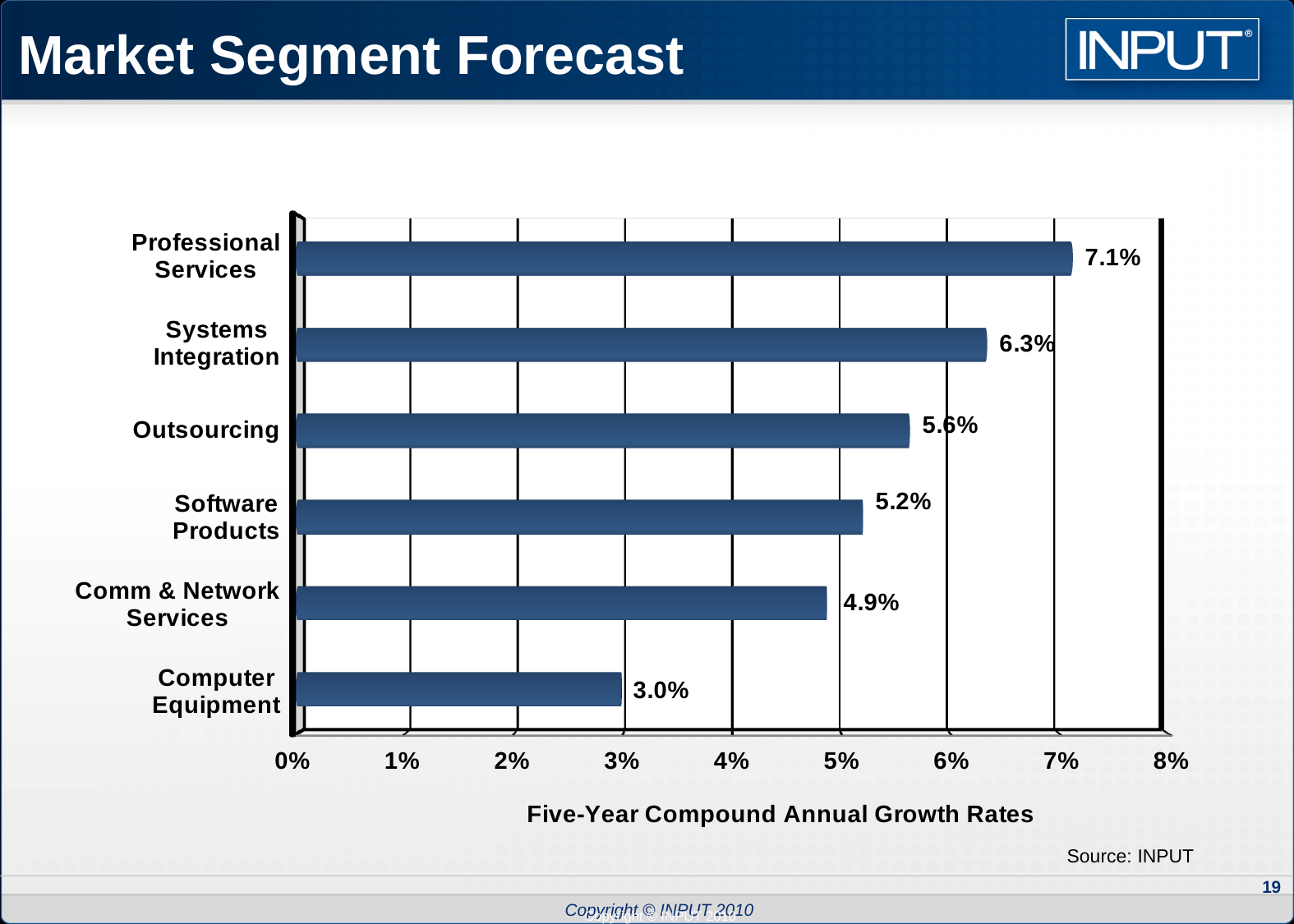
What is the value for Comm & Network Services? 4.9% What is the label below the x axis of the chart? Five-Year Compound Annual Growth Rates Which has a higher growth rate, Outsourcing or Comm & Network Services? Outsourcing What is the value for Outsourcing? 5.6% Is the value for Software Products greater or less than 4%? greater Which market segment has the lowest growth rate? Computer Equipment What is the five-year compound annual growth rate for Professional Services? 7.1% What is the growth rate shown for Computer Equipment? 3.0% What kind of chart is shown on the slide? Bar chart What is the difference between the growth rates of Systems Integration and Software Products? 1.1% Which market segment has the highest growth rate? Professional Services How many market segments are shown in the chart? 6